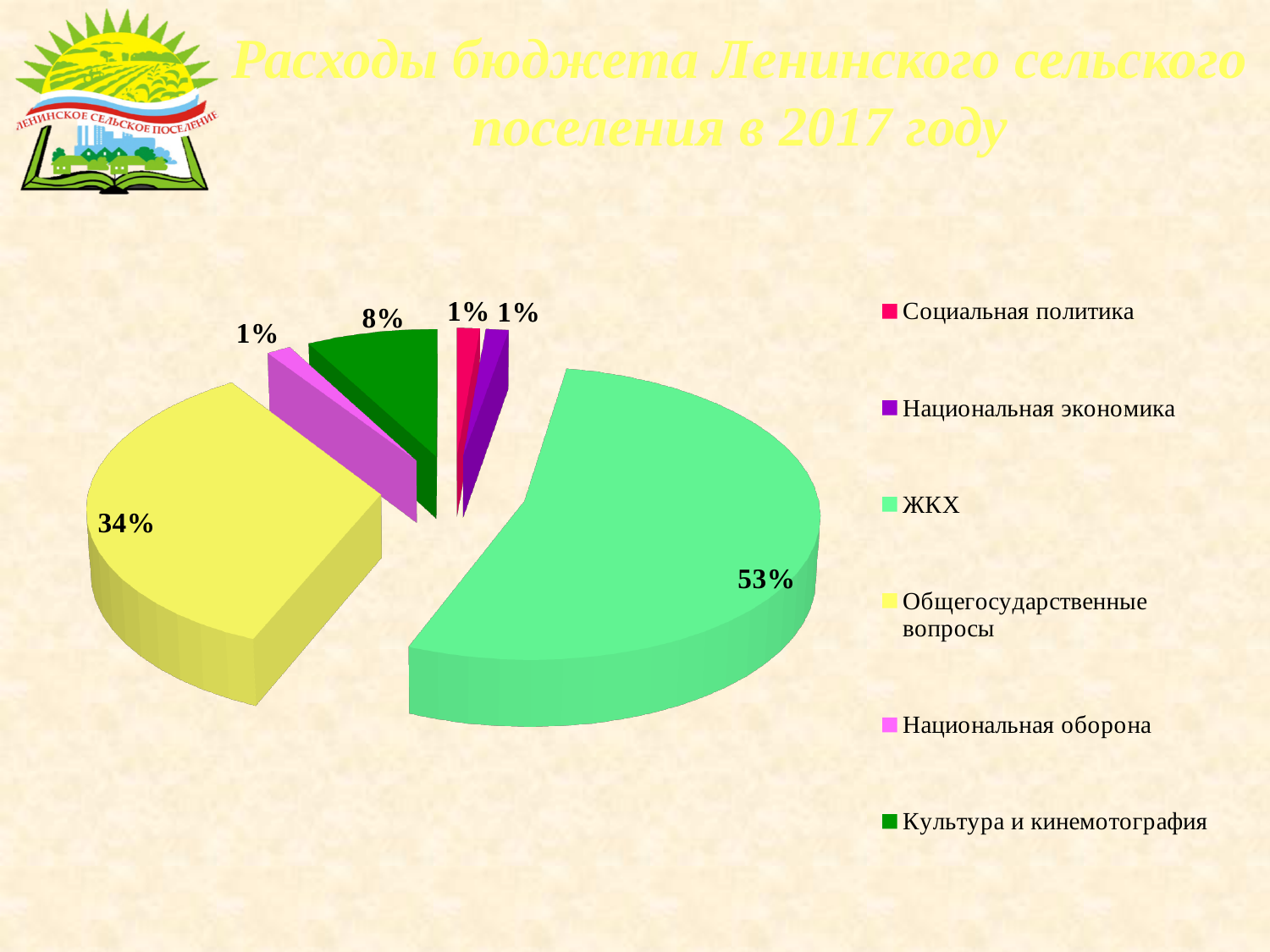
What share of the pie does Национальная оборона have? 1% How many categories does the legend list? 6 Which is larger, the share for Общегосударственные вопросы or the share for Культура и кинемотография? Общегосударственные вопросы What share of the pie does Общегосударственные вопросы have? 34% What share of the pie does ЖКХ have? 53% What colour is the slice for Общегосударственные вопросы? yellow What kind of chart is shown on the slide? pie chart Which category has the largest slice of the pie? ЖКХ What is the difference in percentage points between ЖКХ and Общегосударственные вопросы? 19 What is the title of the chart on the slide? Расходы бюджета Ленинского сельского поселения в 2017 году